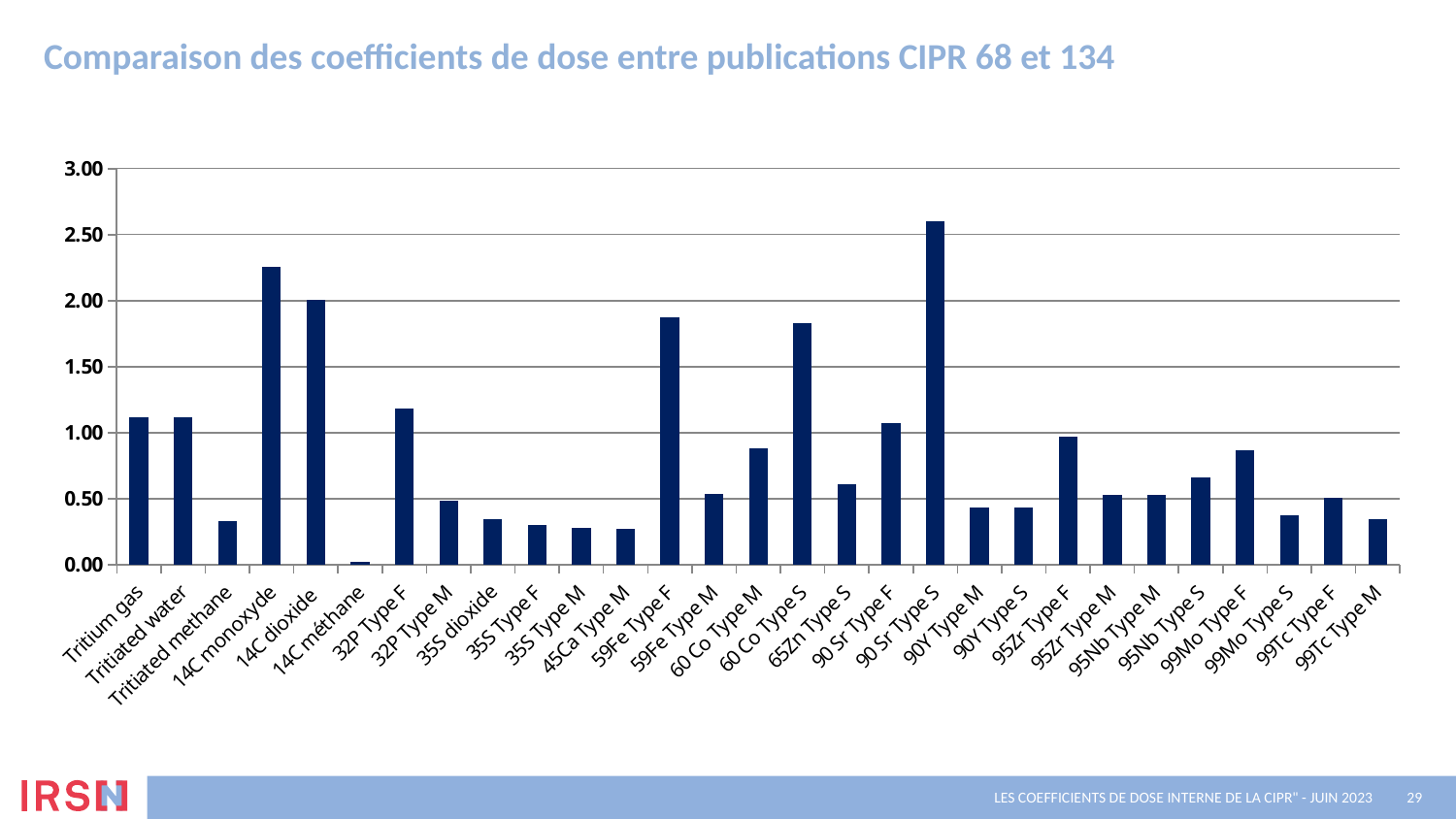
Which is larger, the value for 32P Type F or the value for 32P Type M? 32P Type F Is the value for 90 Sr Type S greater or less than 2.50? greater Which category has the highest bar? 90 Sr Type S Is the value for Tritiated methane greater or less than 0.50? less How many categories are plotted on the x axis? 29 Is the value for 59Fe Type F greater or less than 1.50? greater Which category has the lowest bar? 14C méthane Which is larger, the value for 60 Co Type S or the value for 60 Co Type M? 60 Co Type S What is the title of the chart on the slide? Comparaison des coefficients de dose entre publications CIPR 68 et 134 What kind of chart is shown on the slide? Bar chart